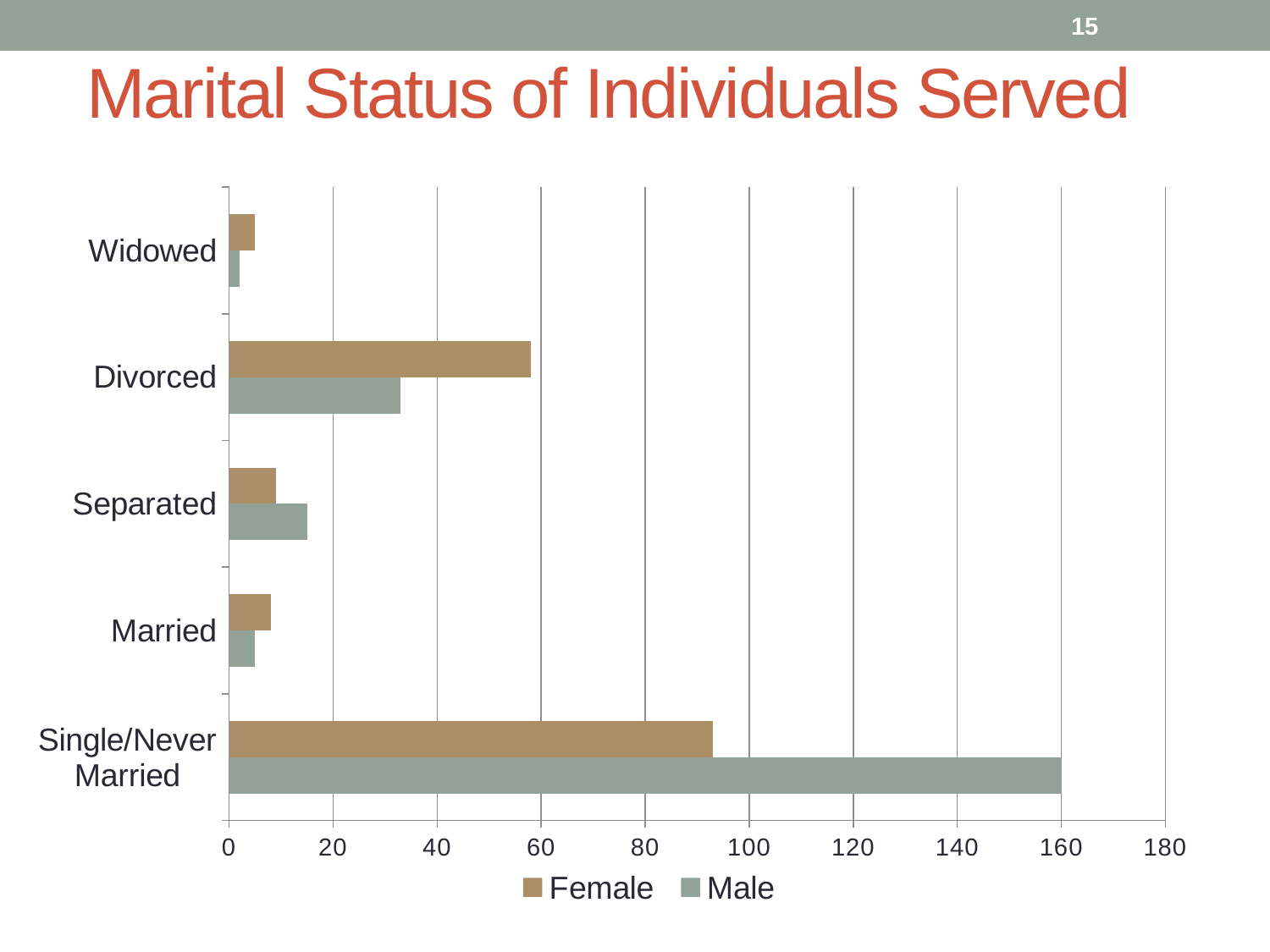
How many series does the legend list? 2 Which marital status category has the highest Female value? Single/Never Married What is the Male value for Single/Never Married? 160 Is the Female value for Divorced greater or less than 40? greater For Separated, which is larger, the Female value or the Male value? Male How many marital status categories are shown on the chart? 5 What is the title of the chart? Marital Status of Individuals Served Which marital status category has the lowest Male value? Widowed What kind of chart is shown on the slide? bar chart For Divorced, which is larger, the Female value or the Male value? Female Is the Female value for Single/Never Married greater or less than 80? greater Which marital status category has the highest Male value? Single/Never Married